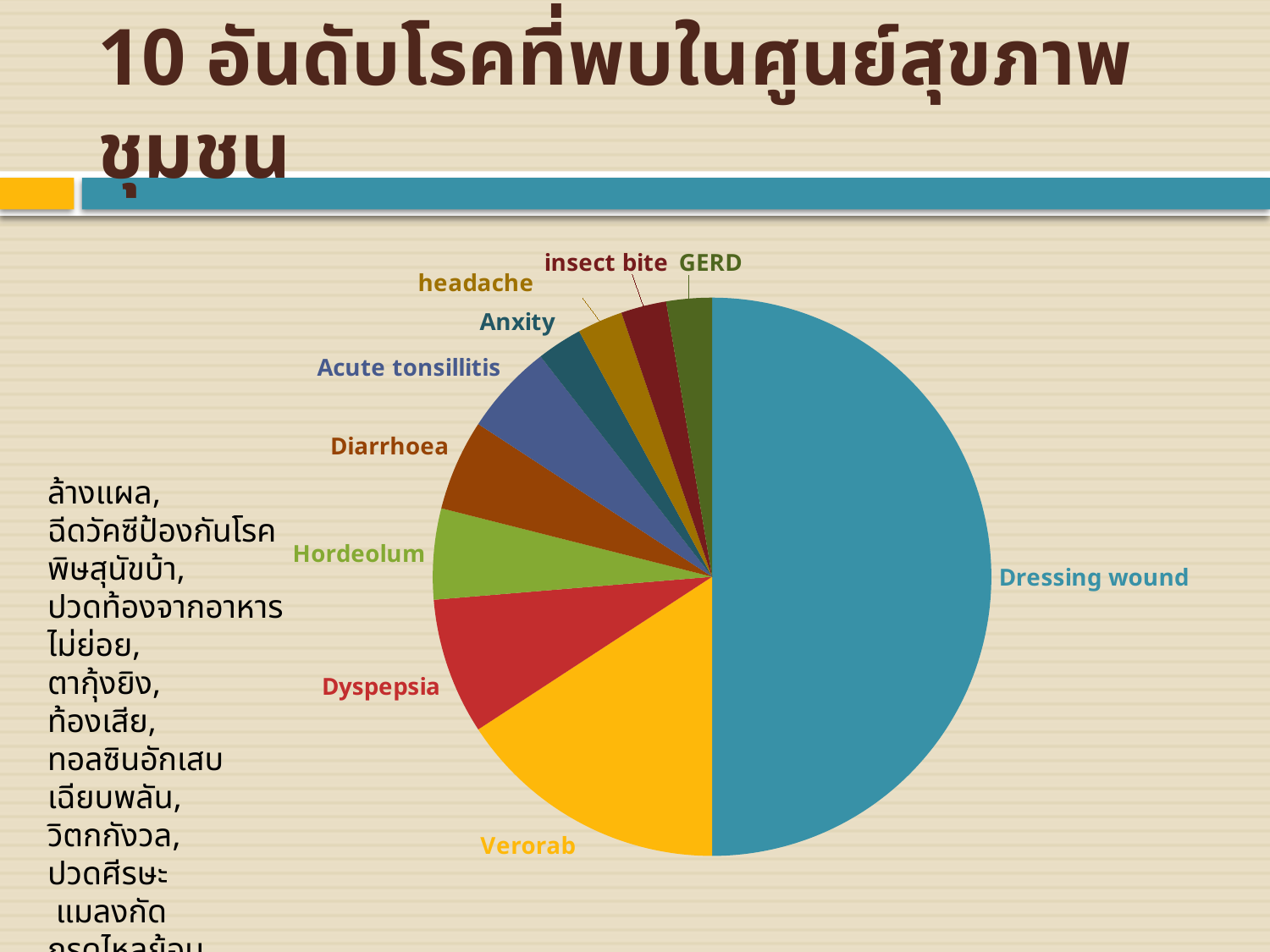
What colour is the Verorab slice? yellow Which slice is larger, Dyspepsia or GERD? Dyspepsia Which slice is larger, Verorab or Hordeolum? Verorab Which slice is larger, Verorab or Dyspepsia? Verorab How many slices does the pie chart have? 10 What colour is the Dressing wound slice? blue Which category has the largest slice of the pie chart? Dressing wound Which category has the second-largest slice of the pie chart? Verorab What kind of chart is shown on the slide? pie chart